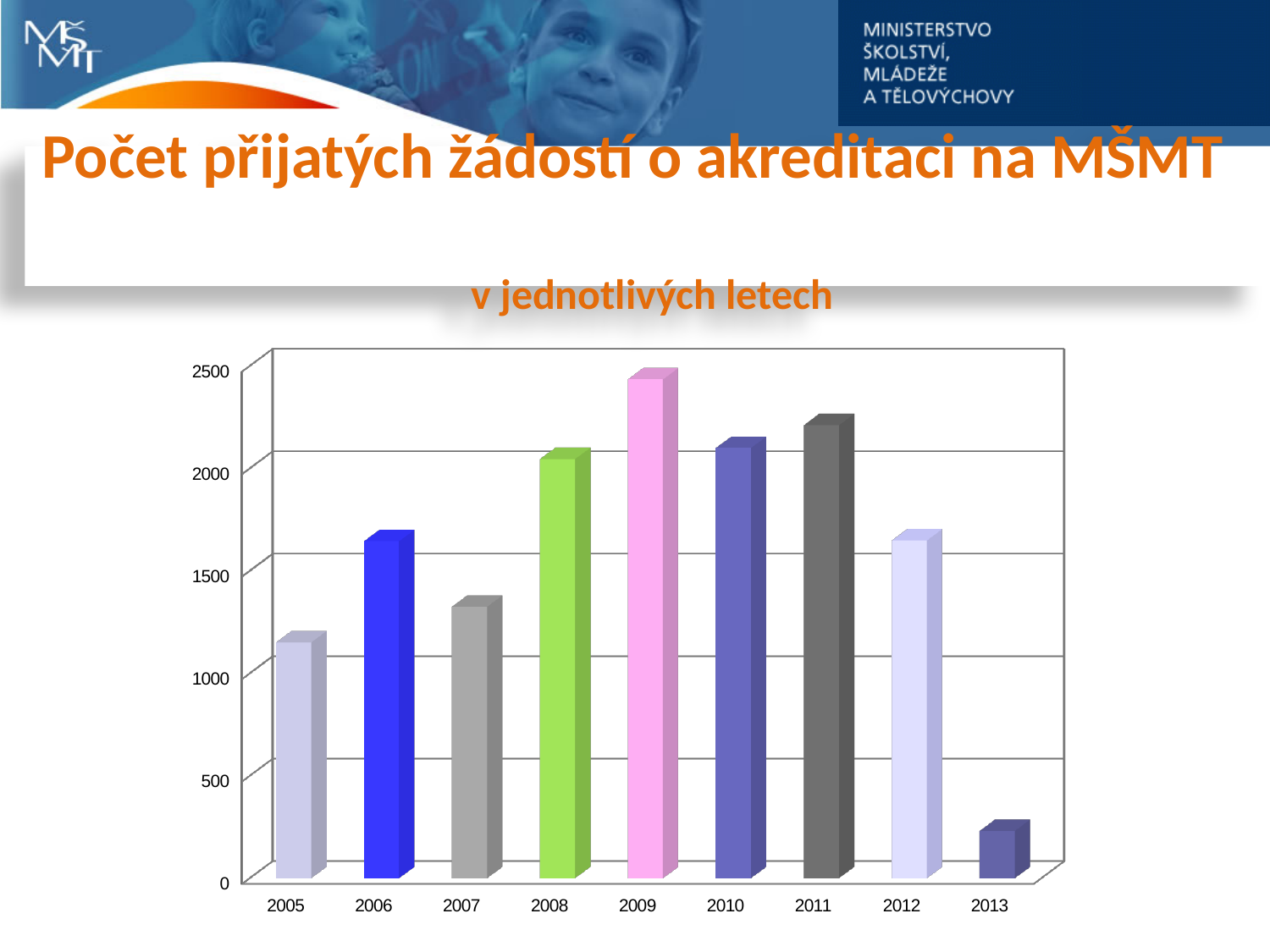
Which year has the highest number of accepted accreditation applications? 2009 Is the value for 2009 greater or less than 2000? greater Is the value for 2007 greater or less than 1500? less Which year has the lowest number of accepted accreditation applications? 2013 Is the value for 2005 greater or less than 1000? greater What kind of chart is shown on the slide? bar chart What is the subtitle shown above the chart? v jednotlivých letech How many years are shown on the x axis of the chart? 9 Which year has the larger value, 2008 or 2007? 2008